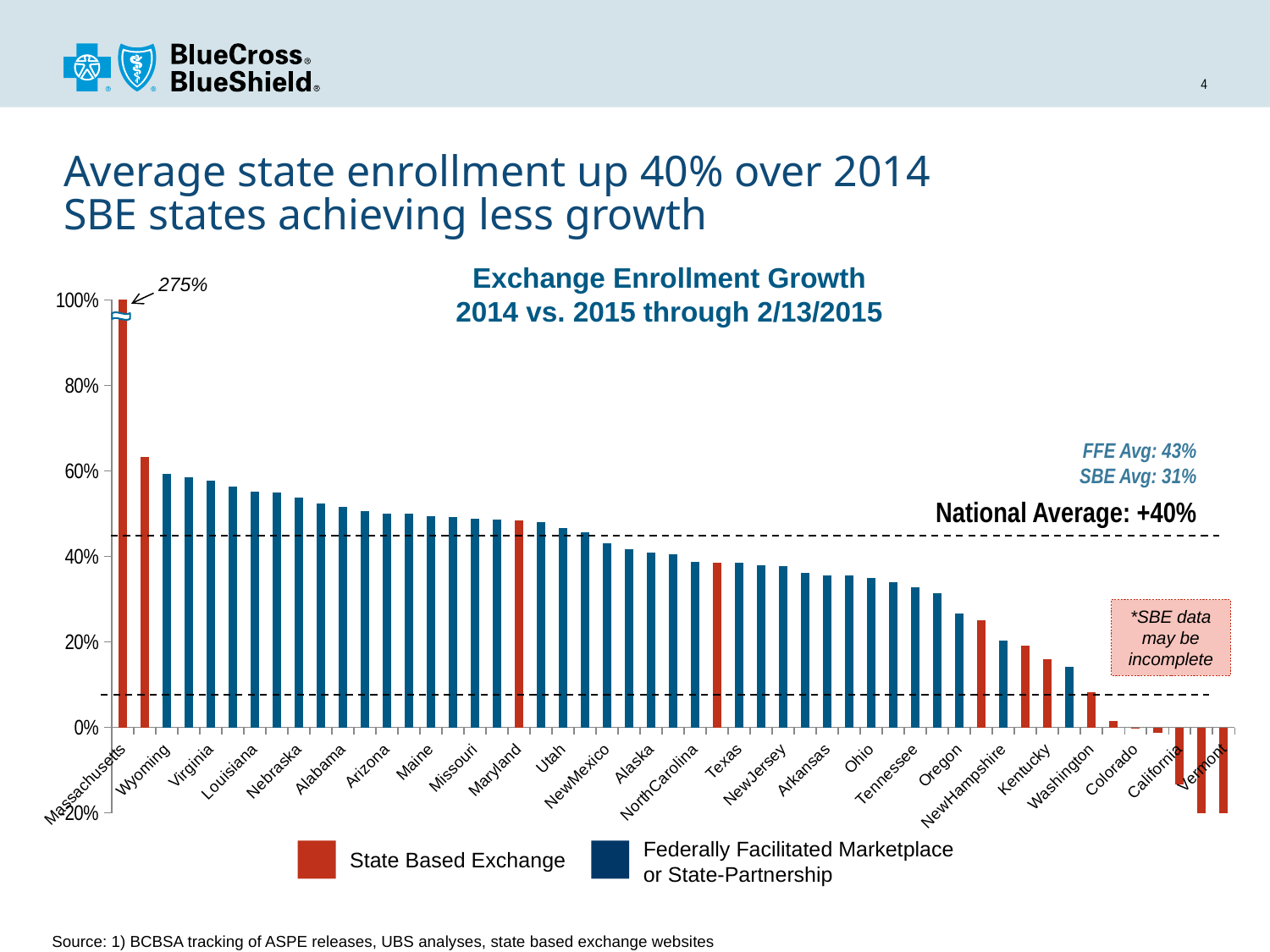
What type of chart is shown on the slide? bar chart What is the enrollment growth value shown for Massachusetts? 275% How many series does the legend list? 2 What is the National Average growth shown on the chart? +40% Is the value for Vermont greater or less than 0%? less What is the title of the chart? Exchange Enrollment Growth 2014 vs. 2015 through 2/13/2015 What is the SBE Avg shown on the chart? 31% What is the FFE Avg shown on the chart? 43% Do the bar values rise or fall moving from left to right along the x axis? fall Which state has the highest enrollment growth? Massachusetts Is the value for Texas greater or less than 40%? less